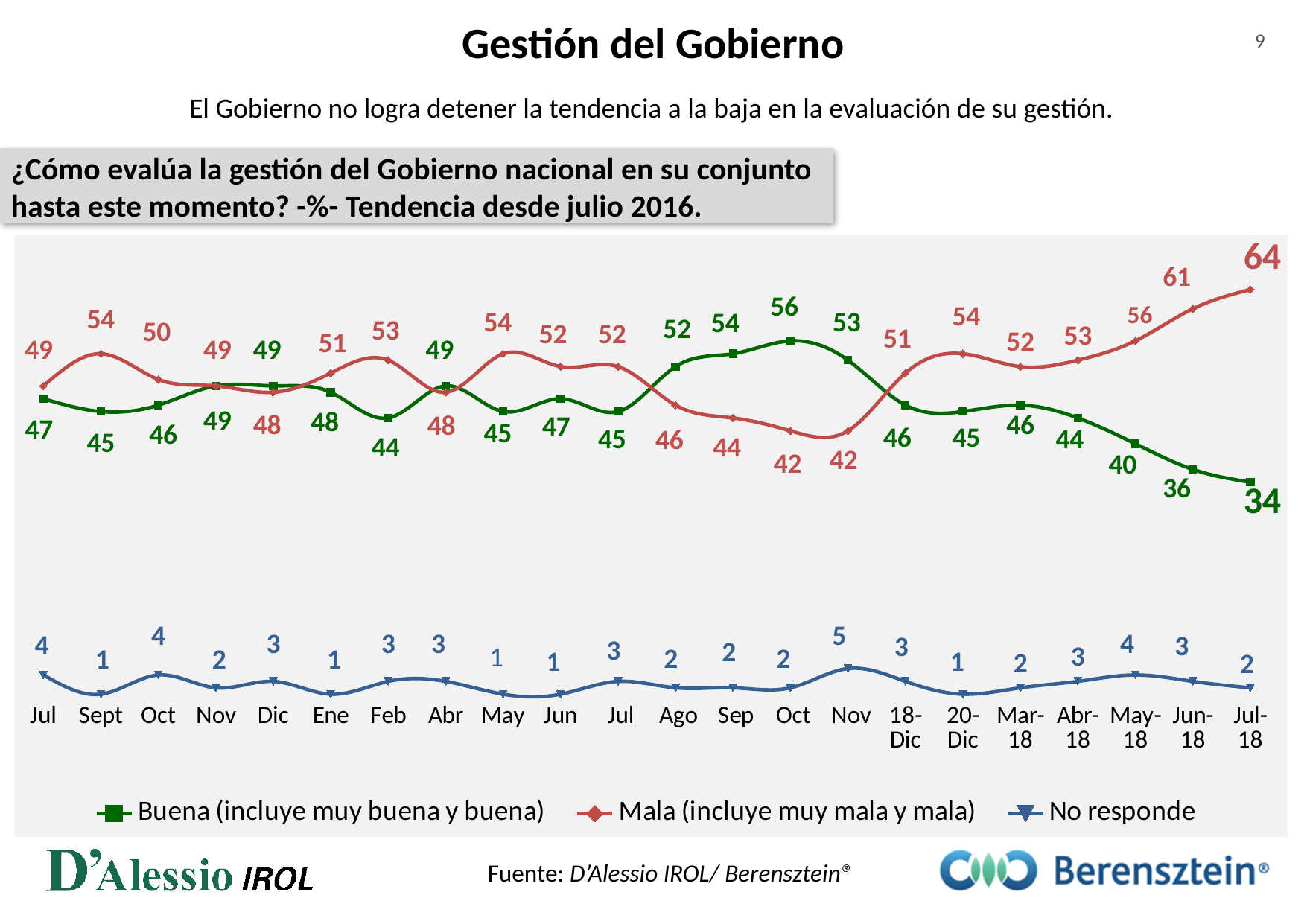
At which point does the Mala series reach its highest value? Jul-18 How many series does the legend list? 3 What kind of chart is shown on the slide? Line chart How many data points does each series have on the x axis? 22 What is the highest value reached by the Buena series? 56 What is the value of the No responde series at Jun-18? 3 At which point does the Buena series reach its lowest value? Jul-18 What is the value of the Mala series at Jul-18? 64 What is the difference between Mala and Buena at Jul-18? 30 What is the value of the Buena series at Jul-18? 34 From Mar-18 to Jul-18, does the Mala series rise or fall? Rise At Sep, which is larger: Buena or Mala? Buena